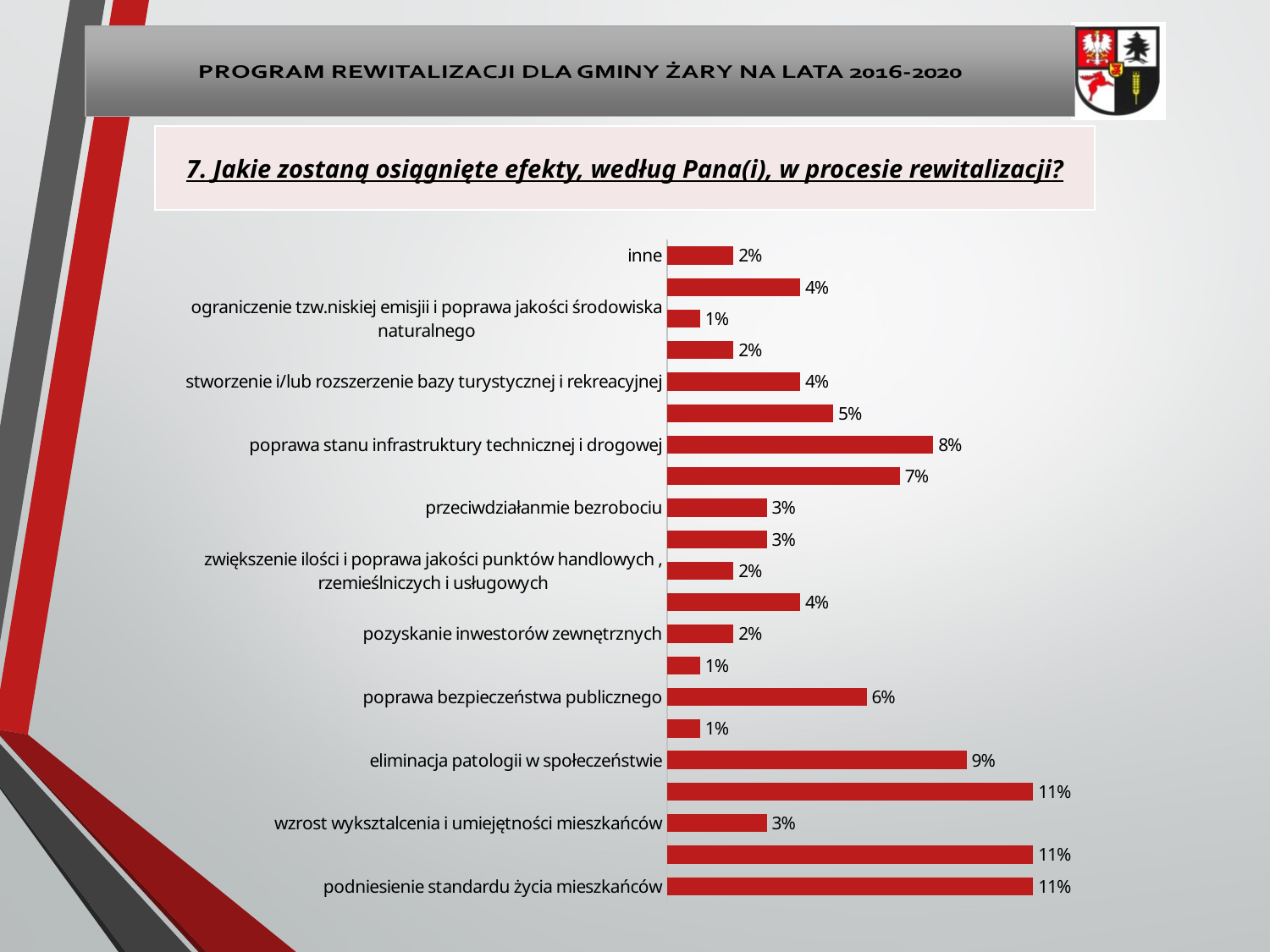
What is the value for "podniesienie standardu życia mieszkańców"? 11% What kind of chart is shown on the slide? Bar chart What is the highest value shown on the chart? 11% What is the value for "inne"? 2% What is the value for "eliminacja patologii w społeczeństwie"? 9% What is the difference between the values for "poprawa stanu infrastruktury technicznej i drogowej" and "poprawa bezpieczeństwa publicznego"? 2 percentage points What is the value for "poprawa stanu infrastruktury technicznej i drogowej"? 8% What is the difference between the values for "eliminacja patologii w społeczeństwie" and "wzrost wykształcenia i umiejętności mieszkańców"? 6 percentage points What is the value for "poprawa bezpieczeństwa publicznego"? 6% How many bars are plotted on the chart? 21 What is the value for "ograniczenie tzw. niskiej emisji i poprawa jakości środowiska naturalnego"? 1% Which has the larger value: "eliminacja patologii w społeczeństwie" or "wzrost wykształcenia i umiejętności mieszkańców"? eliminacja patologii w społeczeństwie